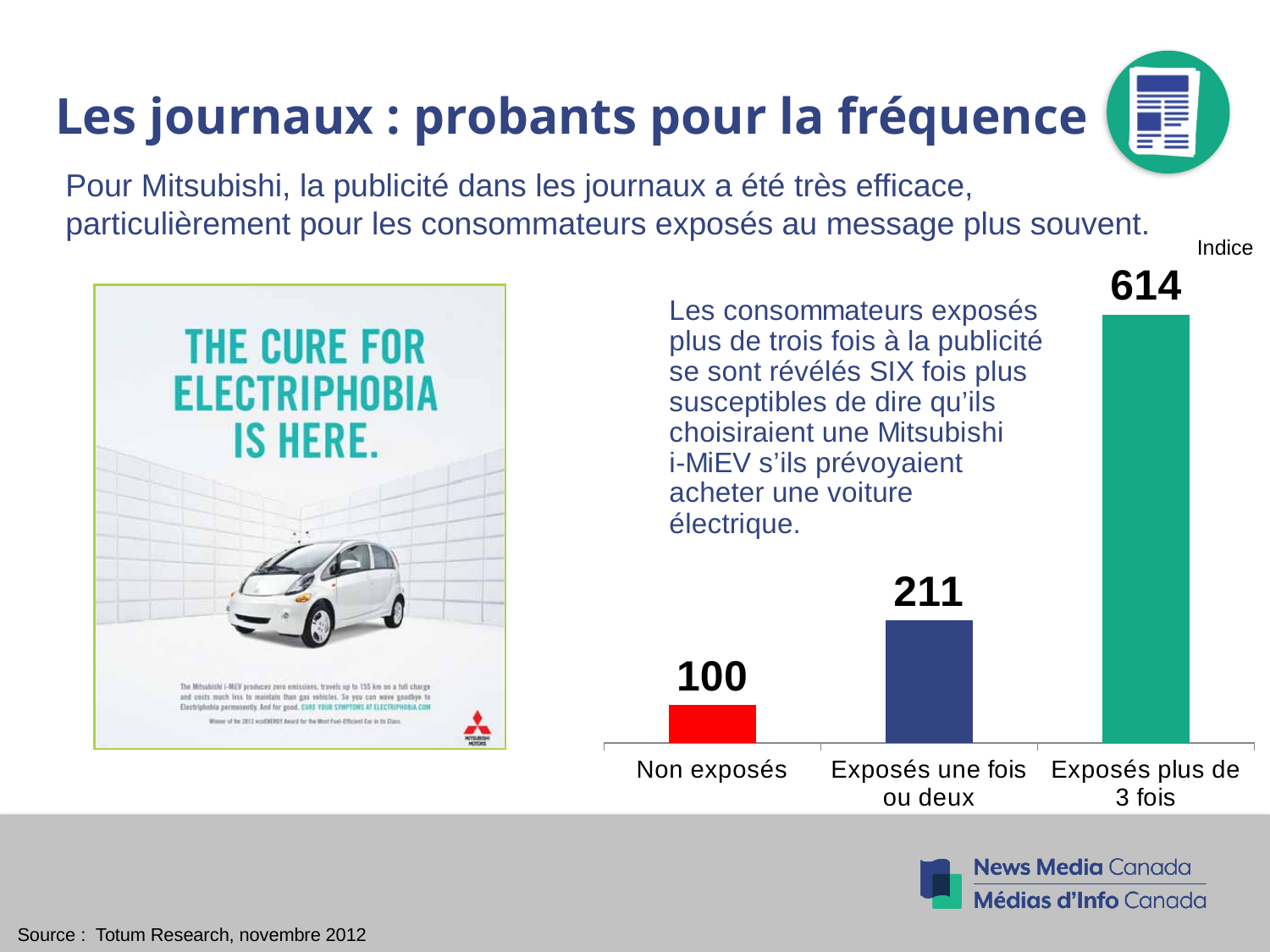
What is the index value for "Exposés plus de 3 fois"? 614 Which is larger, the index for "Exposés une fois ou deux" or for "Exposés plus de 3 fois"? Exposés plus de 3 fois What colour is the bar for "Non exposés"? Red What is the index value for "Exposés une fois ou deux"? 211 Which category has the lowest index value? Non exposés What is the index value for "Non exposés"? 100 What kind of chart is shown on the slide? Bar chart Which category has the highest index value? Exposés plus de 3 fois How many categories are shown in the chart? 3 Do the index values rise or fall from left to right across the categories? Rise What is the difference between the index values for "Exposés une fois ou deux" and "Non exposés"? 111 What is the difference between the index values for "Exposés plus de 3 fois" and "Non exposés"? 514